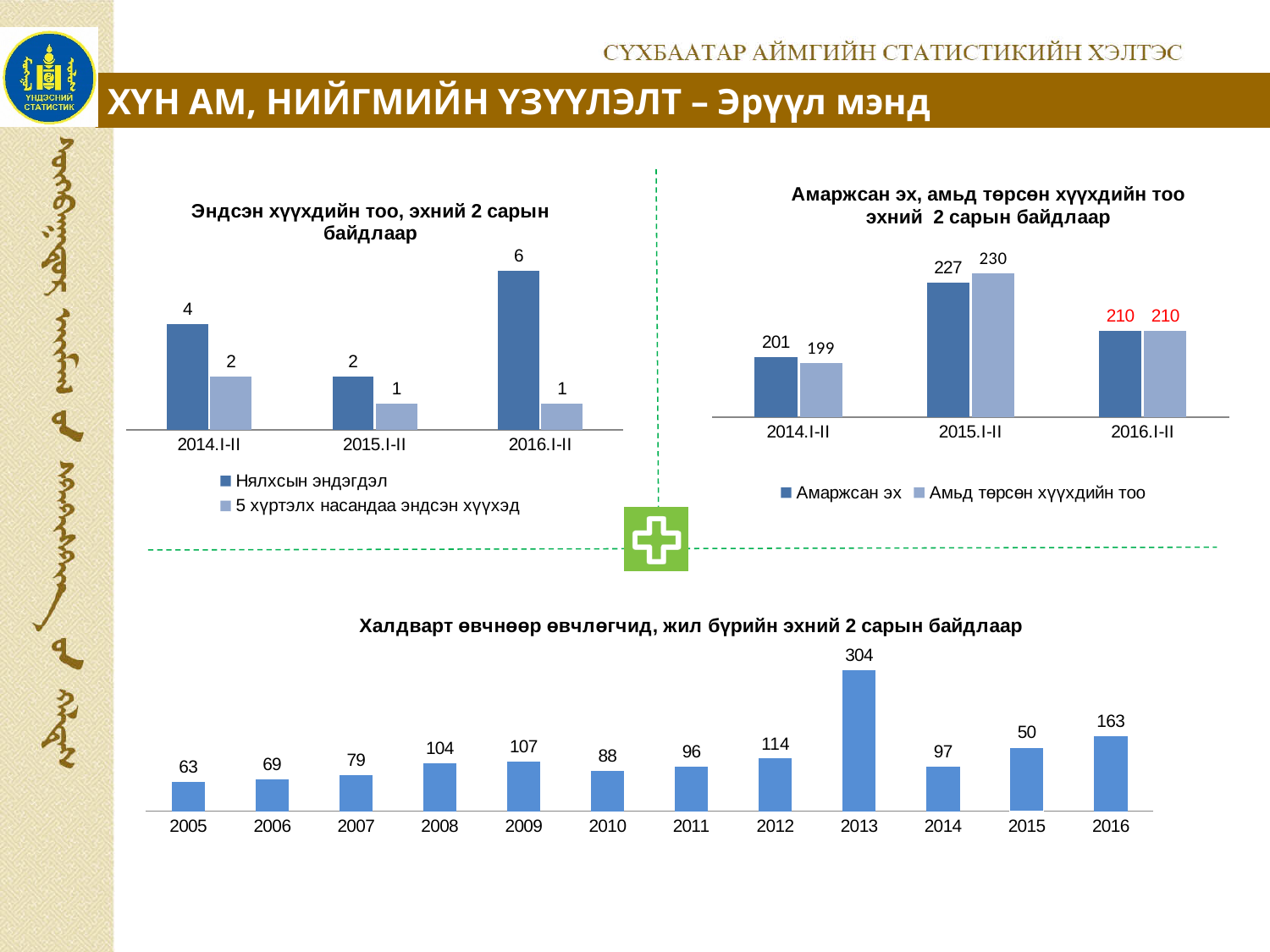
In the top-left chart (Эндсэн хүүхдийн тоо), how many series does the legend list? 2 In the top-left chart (Эндсэн хүүхдийн тоо), what is the value of 5 хүртэлх насандаа эндсэн хүүхэд for 2014.I-II? 2 In the bottom chart (Халдварт өвчнөөр өвчлөгчид), what is the value for 2016? 163 In the bottom chart (Халдварт өвчнөөр өвчлөгчид), what is the difference between the values for 2013 and 2014? 207 In the bottom chart (Халдварт өвчнөөр өвчлөгчид), how many years are shown on the x axis? 12 In the top-right chart (Амаржсан эх, амьд төрсөн хүүхдийн тоо), what is the value of Амьд төрсөн хүүхдийн тоо for 2015.I-II? 230 In the top-right chart (Амаржсан эх, амьд төрсөн хүүхдийн тоо), what is the difference between Амаржсан эх and Амьд төрсөн хүүхдийн тоо for 2014.I-II? 2 In the bottom chart (Халдварт өвчнөөр өвчлөгчид), which year has the highest value? 2013 In the top-right chart (Амаржсан эх, амьд төрсөн хүүхдийн тоо), which period has the highest value for Амаржсан эх? 2015.I-II In the top-left chart (Эндсэн хүүхдийн тоо), what is the value of Нялхсын эндэгдэл for 2016.I-II? 6 In the top-right chart (Амаржсан эх, амьд төрсөн хүүхдийн тоо), what is the value of Амаржсан эх for 2016.I-II? 210